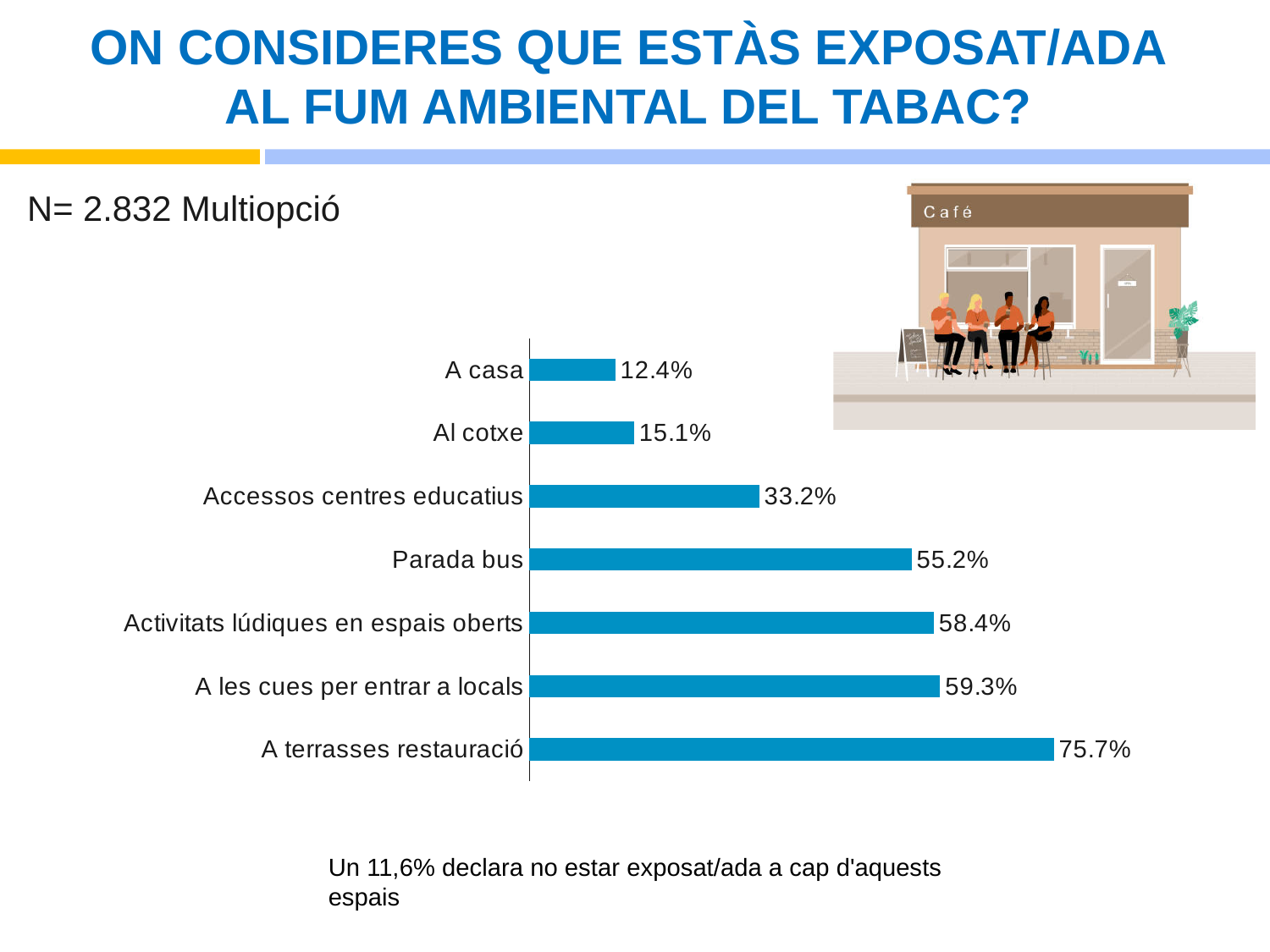
What sample size (N) is stated on the slide? N= 2.832 What is the difference between the values for "Al cotxe" and "A casa"? 2.7% Which is larger, the value for "Parada bus" or the value for "Accessos centres educatius"? Parada bus Which category has the highest value? A terrasses restauració What kind of chart is shown on the slide? Bar chart Which category has the lowest value? A casa What is the value for "A casa"? 12.4% What is the value for "Accessos centres educatius"? 33.2% What is the value for "Parada bus"? 55.2% How many categories are shown in the chart? 7 What is the difference between the values for "A terrasses restauració" and "A les cues per entrar a locals"? 16.4% What is the value for "A terrasses restauració"? 75.7%